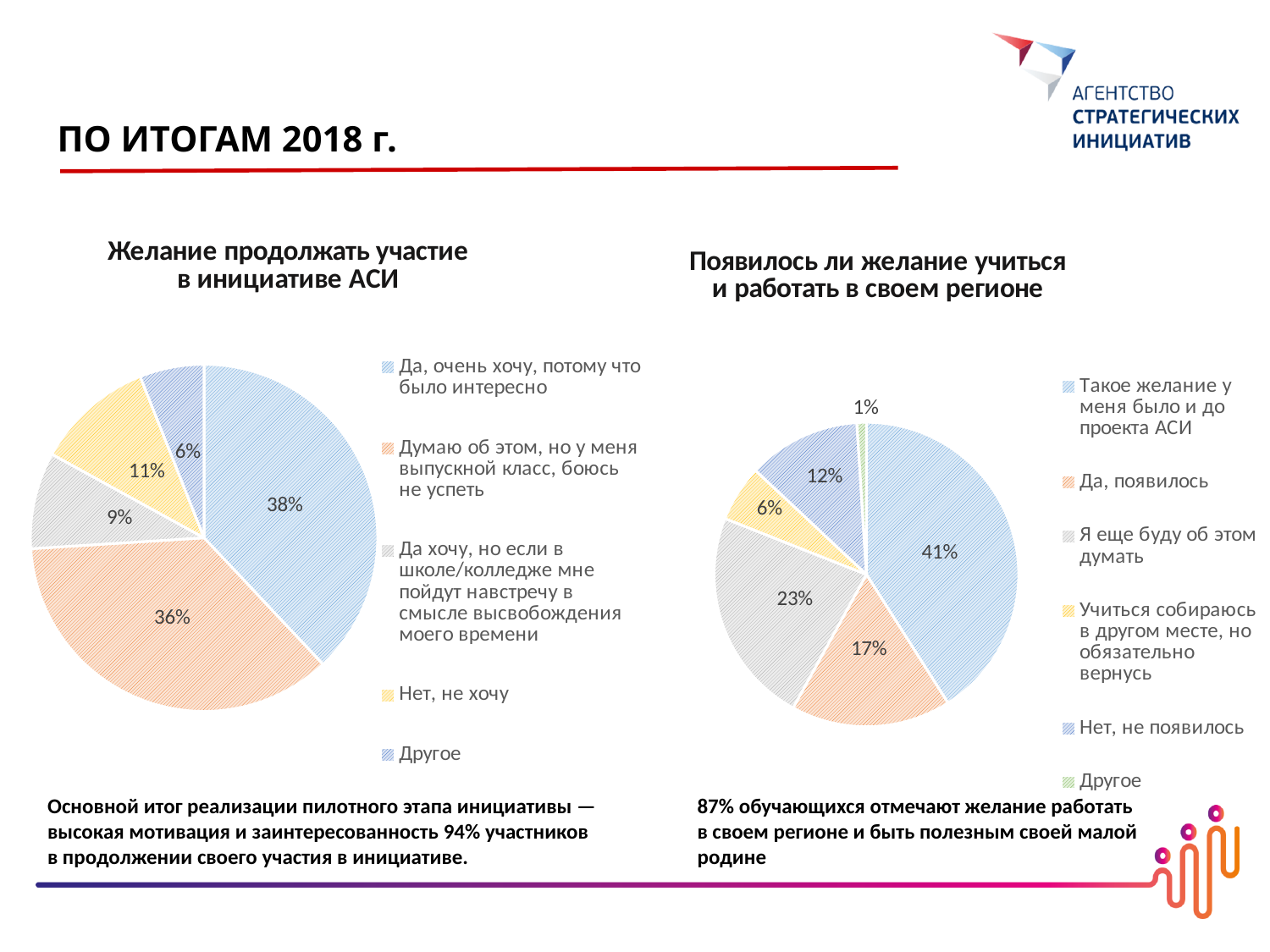
In the chart 'Желание продолжать участие в инициативе АСИ', what share is 'Нет, не хочу'? 11% In the chart 'Желание продолжать участие в инициативе АСИ', what share is 'Да, очень хочу, потому что было интересно'? 38% In the chart 'Появилось ли желание учиться и работать в своем регионе', what share is 'Да, появилось'? 17% In the chart 'Появилось ли желание учиться и работать в своем регионе', which category has the largest share? Такое желание у меня было и до проекта АСИ In the chart 'Появилось ли желание учиться и работать в своем регионе', how many categories does the legend list? 6 What type of chart is used on the left side of the slide? Pie chart In the chart 'Появилось ли желание учиться и работать в своем регионе', what is the difference between 'Я еще буду об этом думать' and 'Да, появилось'? 6% In the chart 'Желание продолжать участие в инициативе АСИ', how many categories does the legend list? 5 In the chart 'Желание продолжать участие в инициативе АСИ', which category has the smallest share? Другое In the chart 'Появилось ли желание учиться и работать в своем регионе', which is larger: 'Нет, не появилось' or 'Учиться собираюсь в другом месте, но обязательно вернусь'? Нет, не появилось In the chart 'Желание продолжать участие в инициативе АСИ', what is the difference between 'Да, очень хочу, потому что было интересно' and 'Думаю об этом, но у меня выпускной класс, боюсь не успеть'? 2%